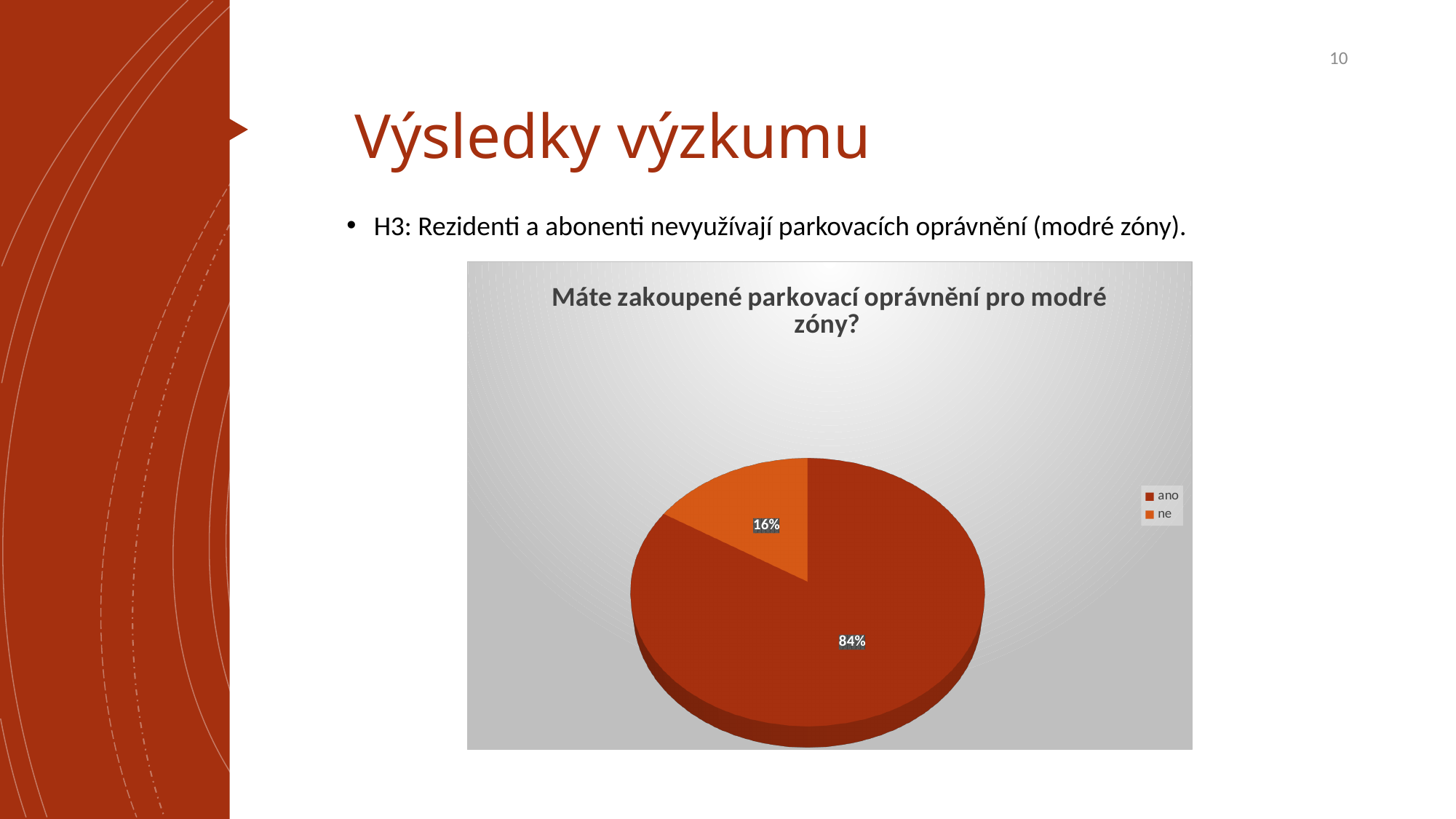
Which slice is the smallest in the pie chart? ne What kind of chart is shown on the slide? pie chart What is the difference in percentage points between the 'ano' and 'ne' slices? 68 What share of the pie does the 'ne' slice represent? 16% How many entries does the legend list? 2 What is the title of the chart? Máte zakoupené parkovací oprávnění pro modré zóny? Which slice is larger, 'ano' or 'ne'? ano Which slice is the largest in the pie chart? ano Which legend entry is shown in the lighter orange colour? ne What share of the pie does the 'ano' slice represent? 84% How many slices does the pie chart have? 2